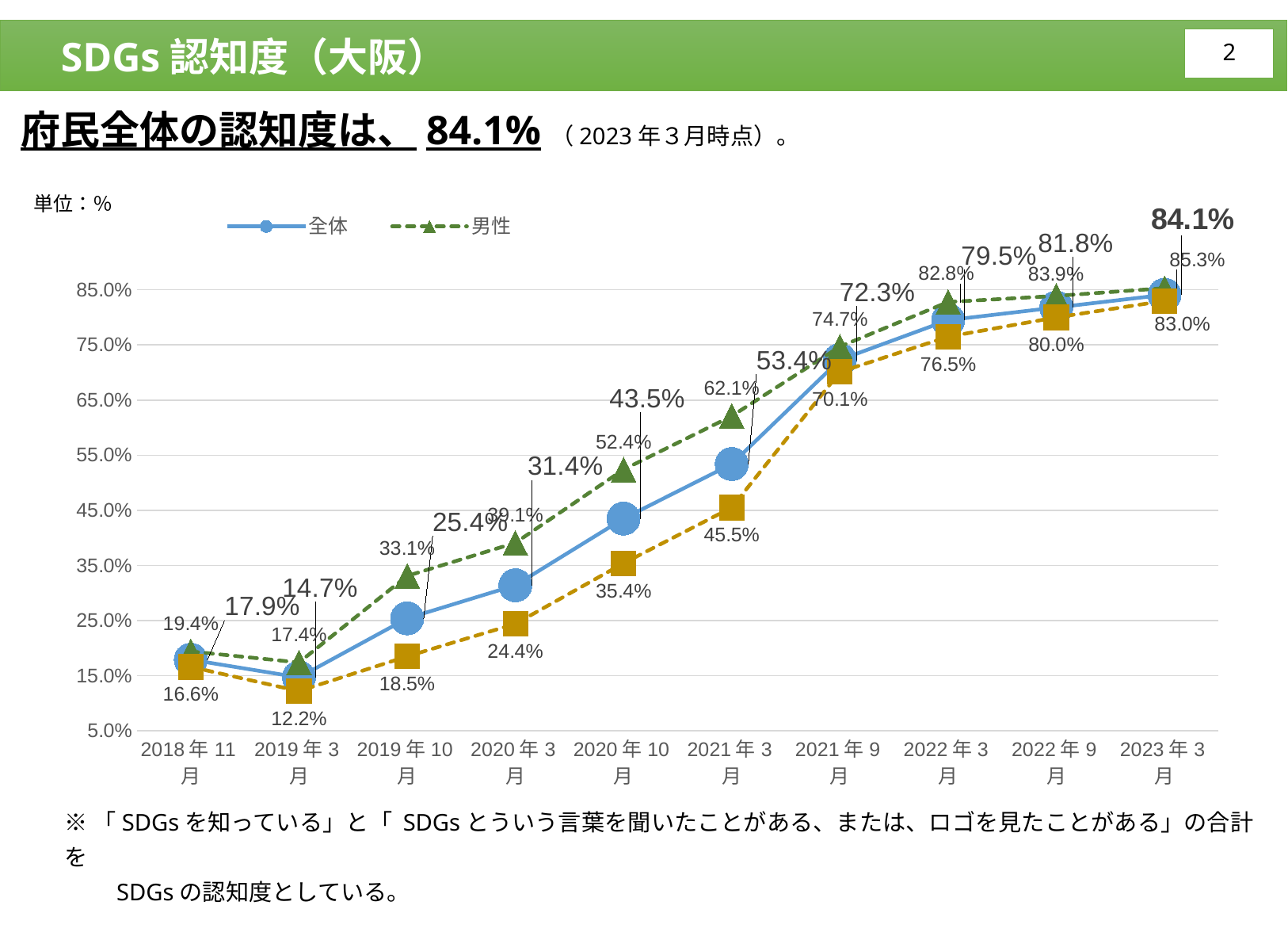
At which time point is the 男性 series highest? 2023年3月 What is the difference between 男性 and 全体 at 2020年10月? 8.9 percentage points What is the value for 男性 at 2021年3月? 62.1% How many time points are shown on the x axis? 10 How many series does the legend list? 2 What kind of chart is shown on the slide? line chart Is the value for 男性 at 2020年3月 greater or less than 45.0%? less At 2021年9月, which is larger: 全体 or 男性? 男性 Does the 全体 series rise or fall from 2019年3月 to 2023年3月? rise At which time point is the 全体 series lowest? 2019年3月 What is the value for 全体 at 2019年3月? 14.7% What is the value for 全体 at 2023年3月? 84.1%